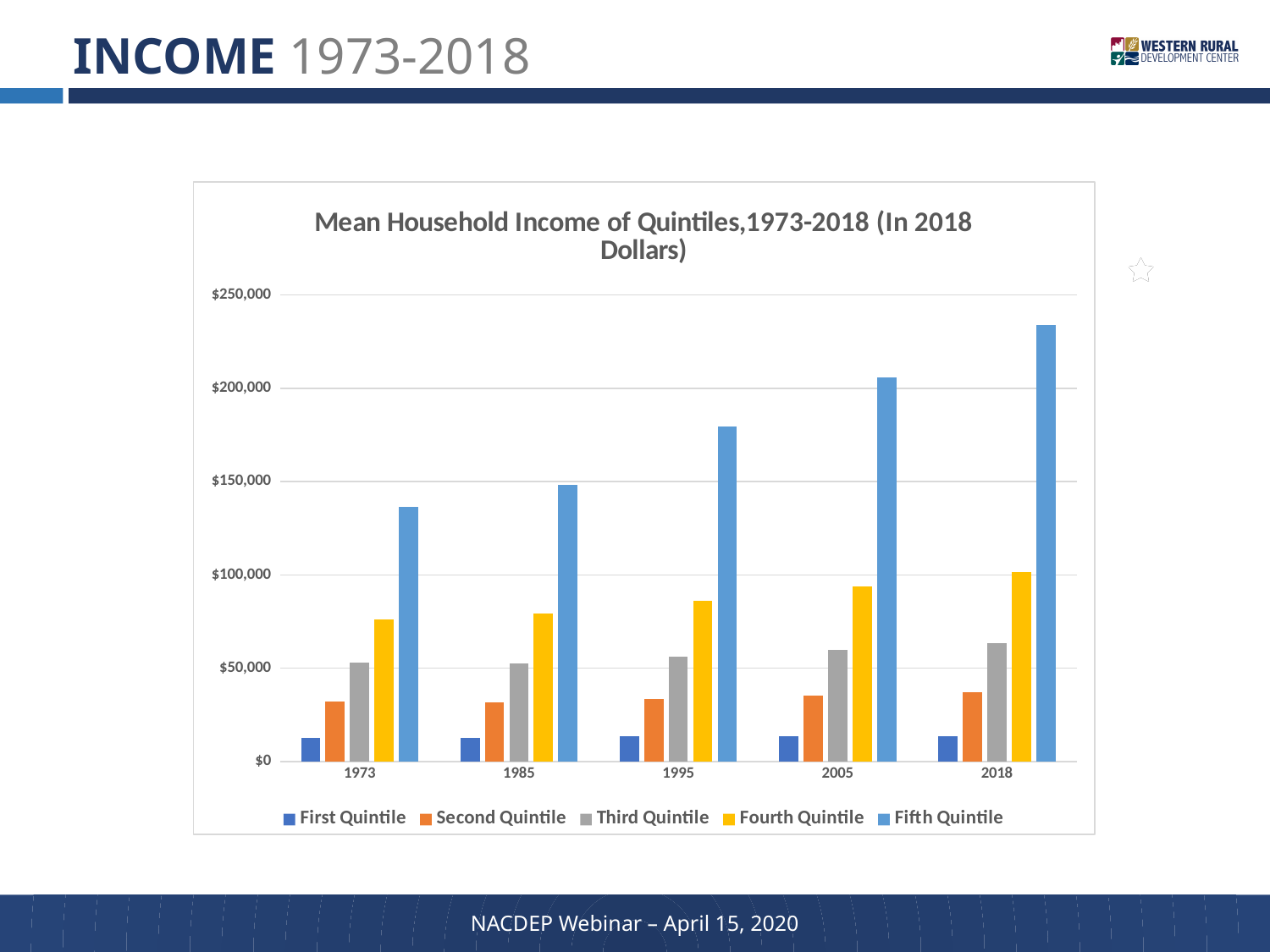
What is the title of the chart? Mean Household Income of Quintiles,1973-2018 (In 2018 Dollars) Is the value for the Fifth Quintile in 1973 greater or less than $150,000? less Does the Fifth Quintile's mean household income rise or fall from 1973 to 2018? rise In which year is the Fifth Quintile bar the tallest? 2018 How many years are shown along the x axis? 5 Which quintile has the highest mean household income in 2018? Fifth Quintile Is the value for the First Quintile in 2018 greater or less than $50,000? less Which quintile has the lowest mean household income in 1973? First Quintile How many series does the legend list? 5 What kind of chart is shown on the slide? bar chart Is the value for the Fourth Quintile in 1973 greater or less than $50,000? greater